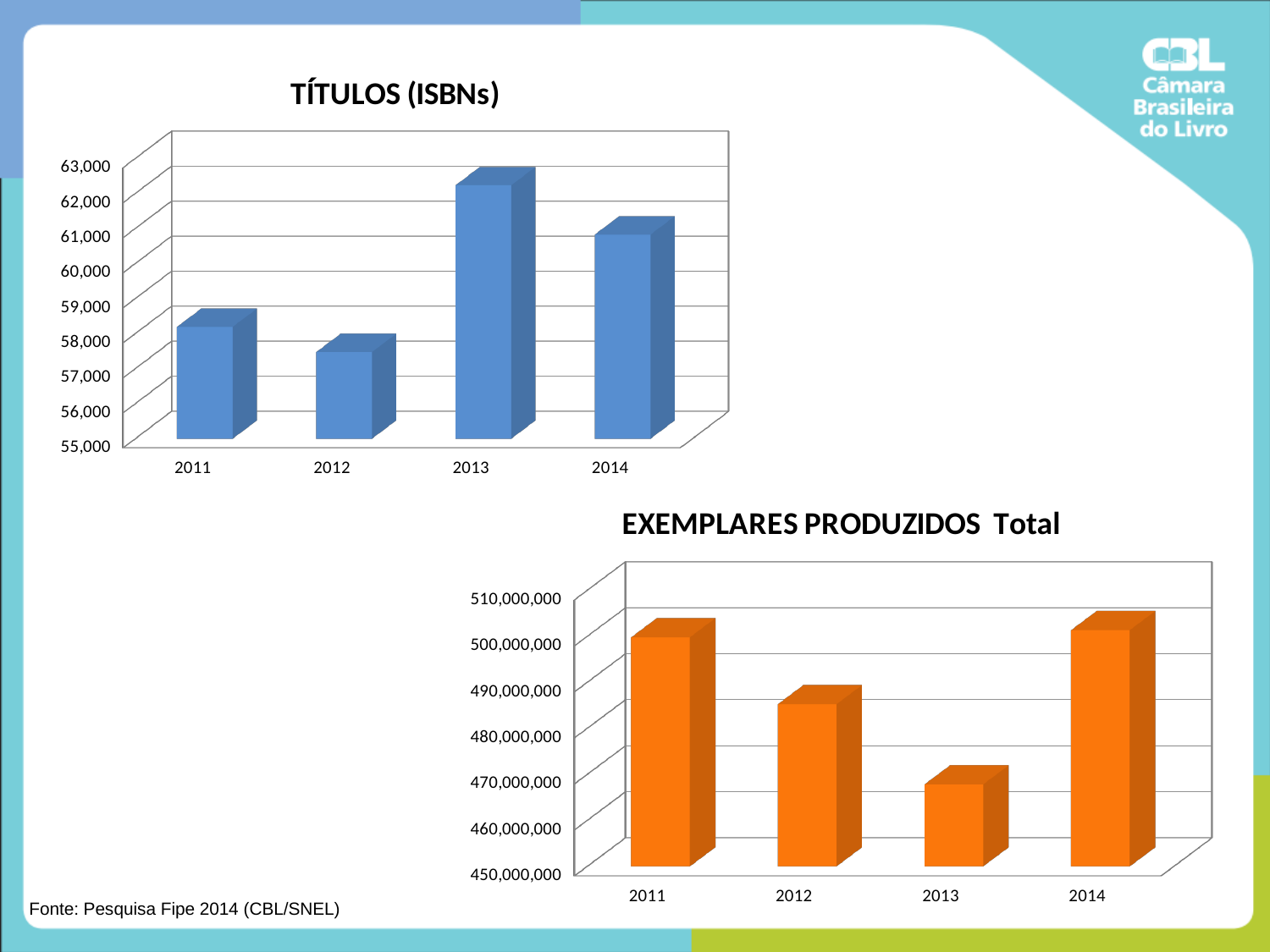
In the "TÍTULOS (ISBNs)" chart, which year has the highest value? 2013 What kind of chart is the "TÍTULOS (ISBNs)" chart? Bar chart In the "EXEMPLARES PRODUZIDOS Total" chart, which is larger, the value for 2012 or the value for 2013? 2012 In the "EXEMPLARES PRODUZIDOS Total" chart, which year has the lowest value? 2013 In the "TÍTULOS (ISBNs)" chart, which year has the lowest value? 2012 In the "TÍTULOS (ISBNs)" chart, which is larger, the value for 2013 or the value for 2014? 2013 In the "EXEMPLARES PRODUZIDOS Total" chart, is the value for 2011 greater or less than 490,000,000? greater What colour are the bars in the "EXEMPLARES PRODUZIDOS Total" chart? Orange How many years are shown on the x axis of the "TÍTULOS (ISBNs)" chart? 4 In the "TÍTULOS (ISBNs)" chart, is the value for 2011 greater or less than 59,000? less In the "TÍTULOS (ISBNs)" chart, is the value for 2013 greater or less than 61,000? greater